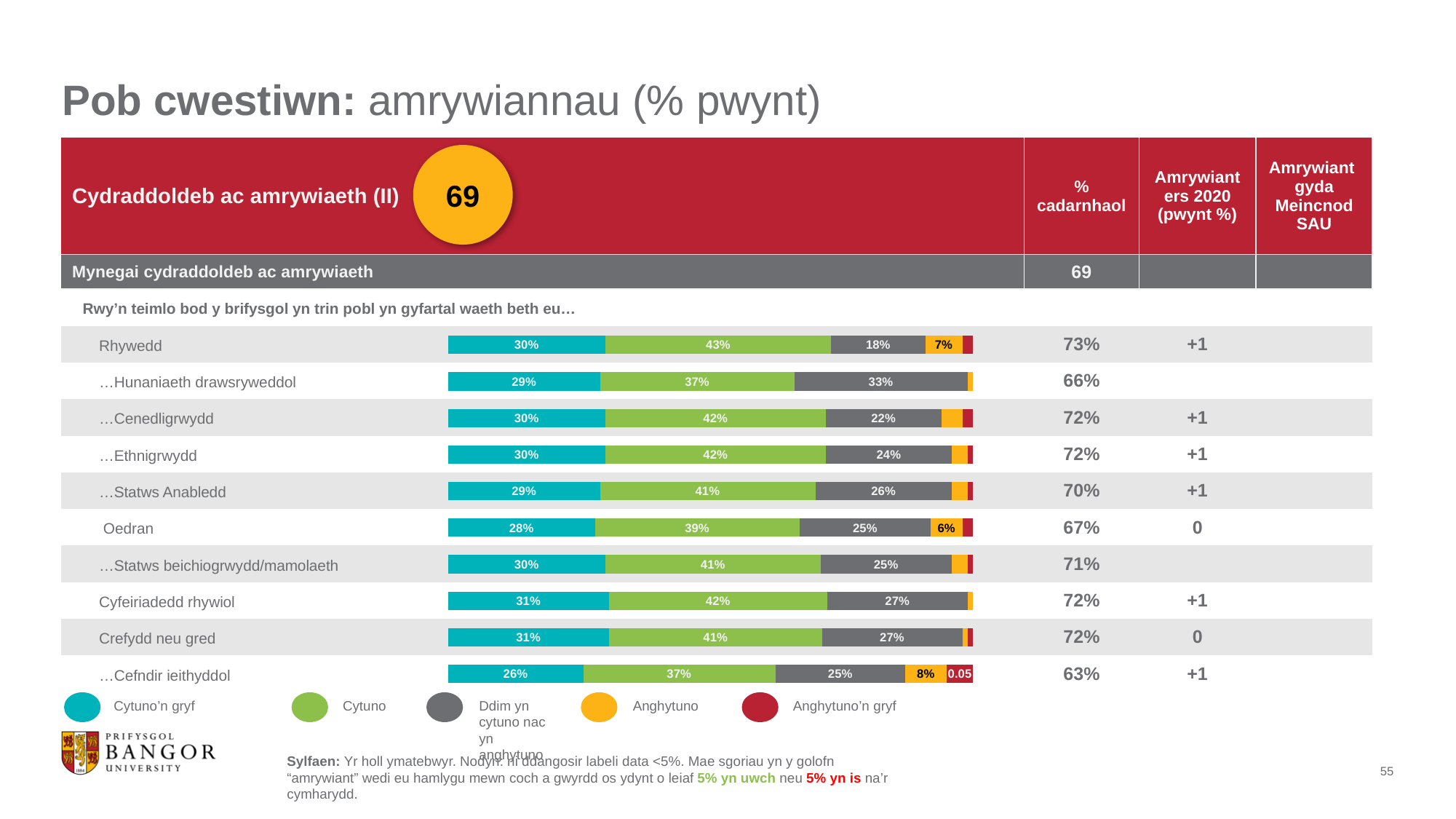
Which category has the lowest 'Cytuno'n gryf' value? …Cefndir ieithyddol What is the 'Cytuno' value for …Hunaniaeth drawsryweddol? 37% Which has the larger 'Cytuno'n gryf' value, Cyfeiriadedd rhywiol or Oedran? Cyfeiriadedd rhywiol What is the 'Anghytuno' value for Oedran? 6% Which legend series is shown in red? Anghytuno'n gryf What is the 'Ddim yn cytuno nac yn anghytuno' value for …Cefndir ieithyddol? 25% Which category has the highest 'Ddim yn cytuno nac yn anghytuno' value? …Hunaniaeth drawsryweddol How many categories (bars) are shown in the chart? 10 What kind of chart is shown on the slide? Stacked bar chart What is the difference between the 'Cytuno' value for Rhywedd and the 'Cytuno' value for …Cefndir ieithyddol? 6 percentage points What is the 'Cytuno'n gryf' value for Rhywedd? 30% How many series does the legend list? 5